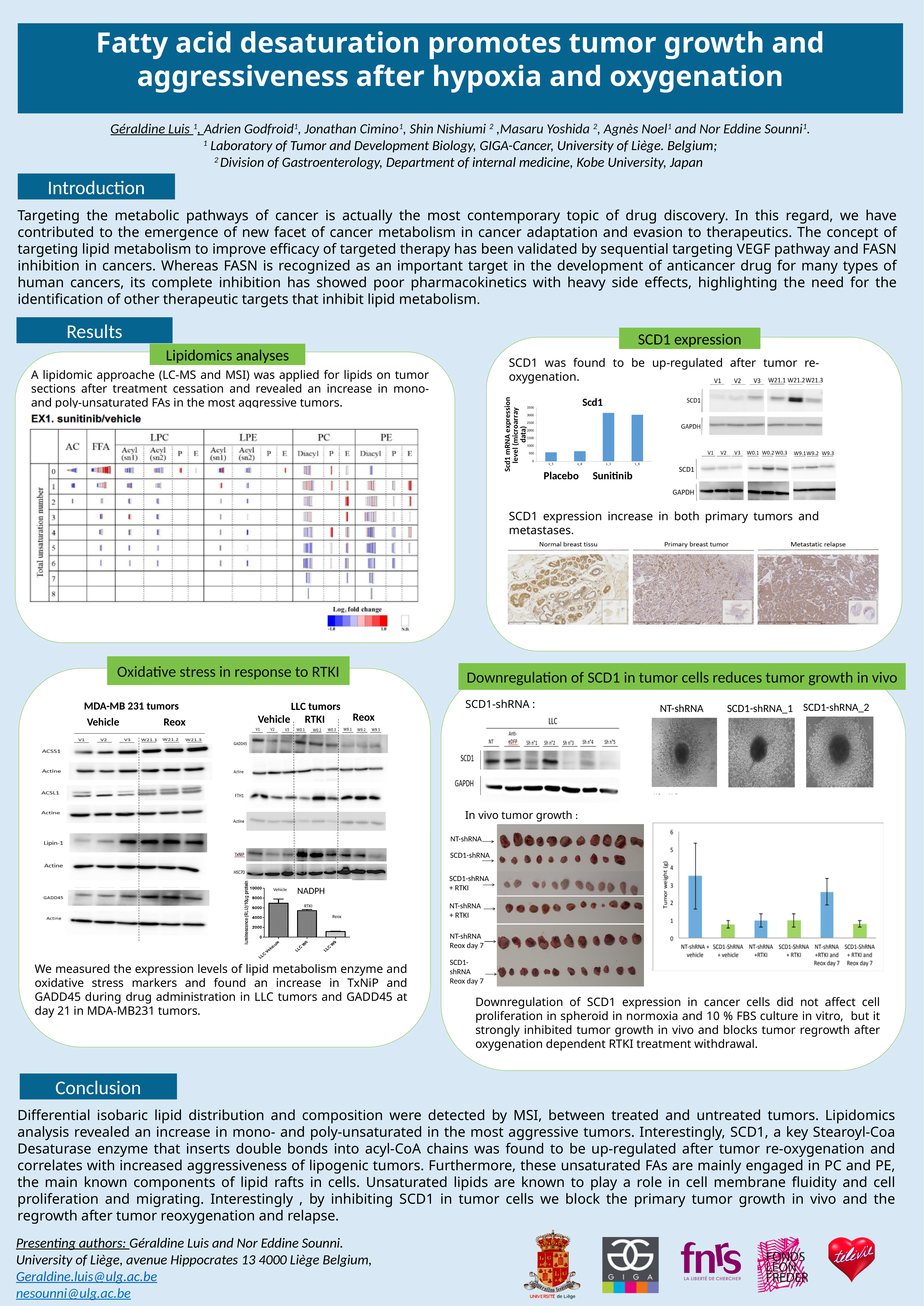
In the NADPH chart, which category has the lowest value? LLC W9 In the NADPH chart, is the value for LLC W9 greater or less than 2000? less In the NADPH chart, do the values rise or fall from left to right? fall In the Scd1 mRNA expression chart, how many bars are plotted? 4 What kind of chart is the Scd1 mRNA expression chart in the SCD1 expression section? bar chart In the Scd1 mRNA expression chart, is the value for s_1 greater or less than 2500? greater In the tumor weight chart, which category has the highest value? NT-shRNA + vehicle In the tumor weight chart, is the value for NT-shRNA +RTKI and Reox day 7 greater or less than 2? greater In the NADPH chart, which category has the highest value? LLC Vehicle In the Scd1 mRNA expression chart, which is larger, the value for v_5 (Placebo) or s_1 (Sunitinib)? s_1 (Sunitinib) In the tumor weight chart, how many categories are plotted? 6